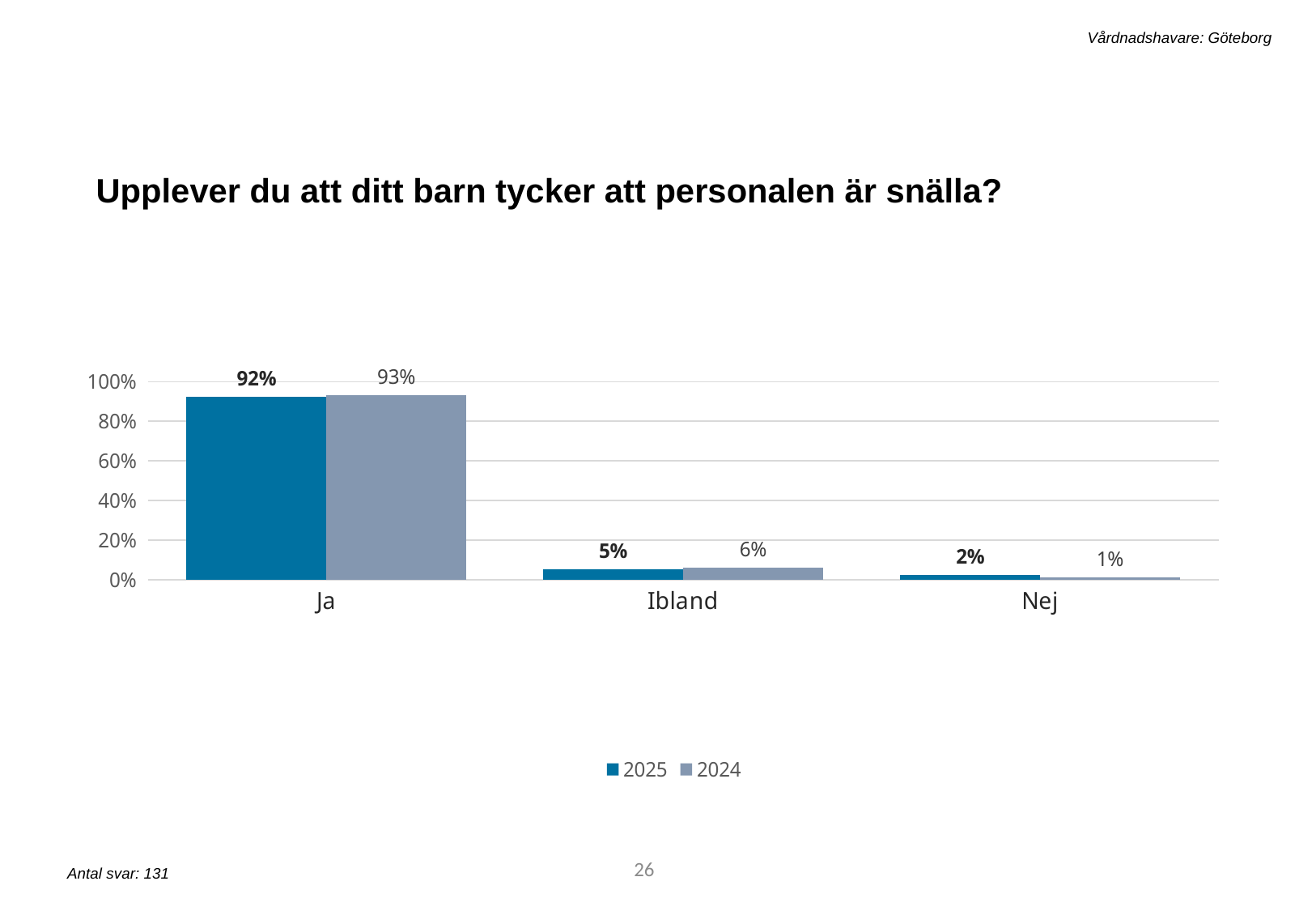
Is the value for Ja in 2024 greater or less than 80%? greater Which is larger for Nej: the 2025 value or the 2024 value? 2025 What is the value for Nej in the 2024 series? 1% How many series does the legend list? 2 What is the value for Ibland in the 2025 series? 5% What is the value for Ja in the 2025 series? 92% What is the value for Ja in the 2024 series? 93% Which category has the lowest value in the 2024 series? Nej How many categories are shown on the x axis? 3 What is the difference between the 2025 and 2024 values for Ibland? 1% Which category has the highest value in the 2025 series? Ja What kind of chart is shown on the slide? bar chart